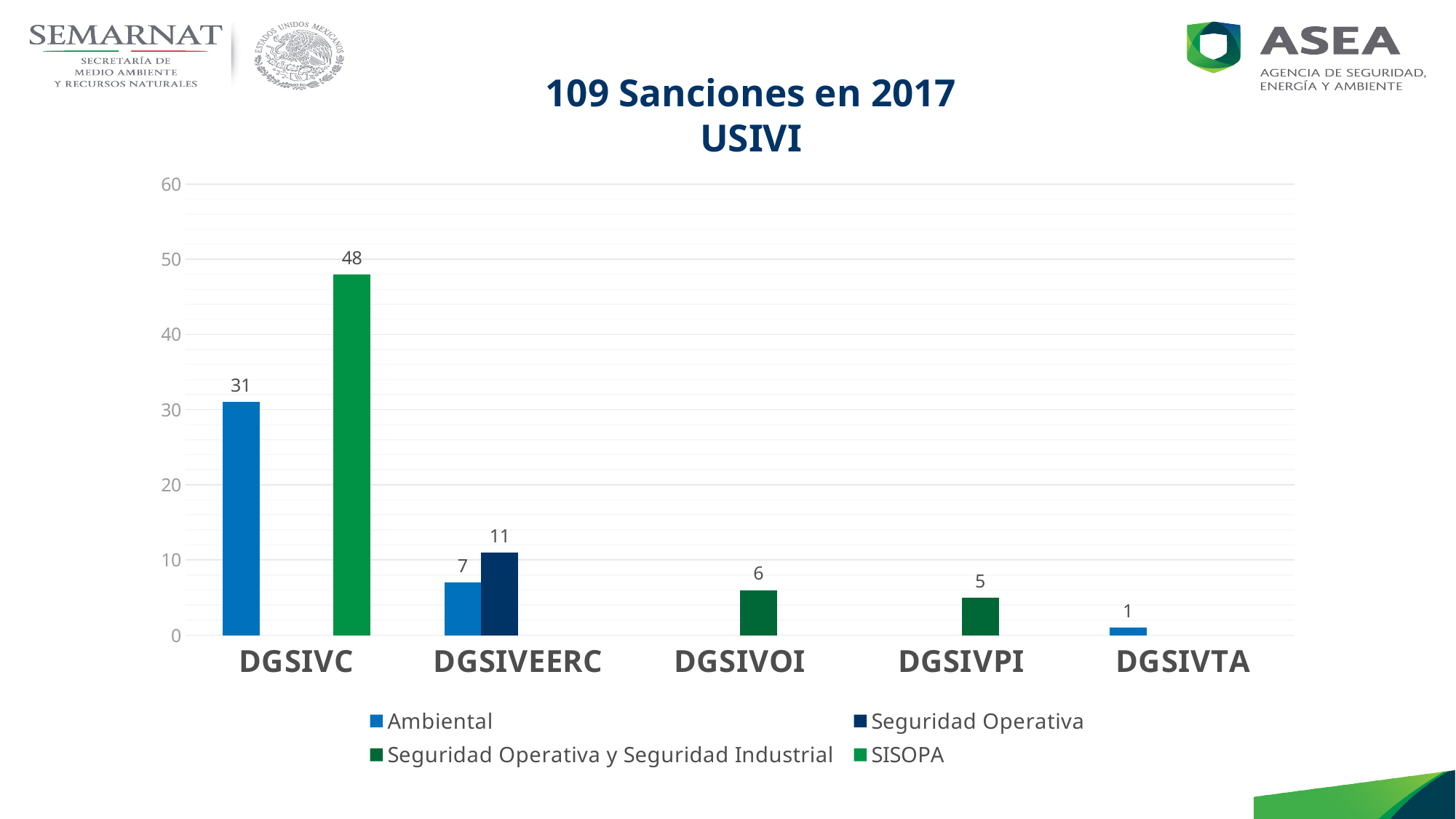
What is the Seguridad Operativa value for DGSIVEERC? 11 What kind of chart is shown on the slide? Bar chart What is the Ambiental value for DGSIVC? 31 Which is larger: the Seguridad Operativa y Seguridad Industrial value for DGSIVOI or for DGSIVPI? DGSIVOI What is the Seguridad Operativa y Seguridad Industrial value for DGSIVOI? 6 What is the difference between the SISOPA value and the Ambiental value for DGSIVC? 17 What is the title of the chart? 109 Sanciones en 2017 USIVI Which category has the highest single bar in the chart? DGSIVC What is the Ambiental value for DGSIVTA? 1 How many categories are shown on the x axis? 5 What is the SISOPA value for DGSIVC? 48 How many series does the legend list? 4